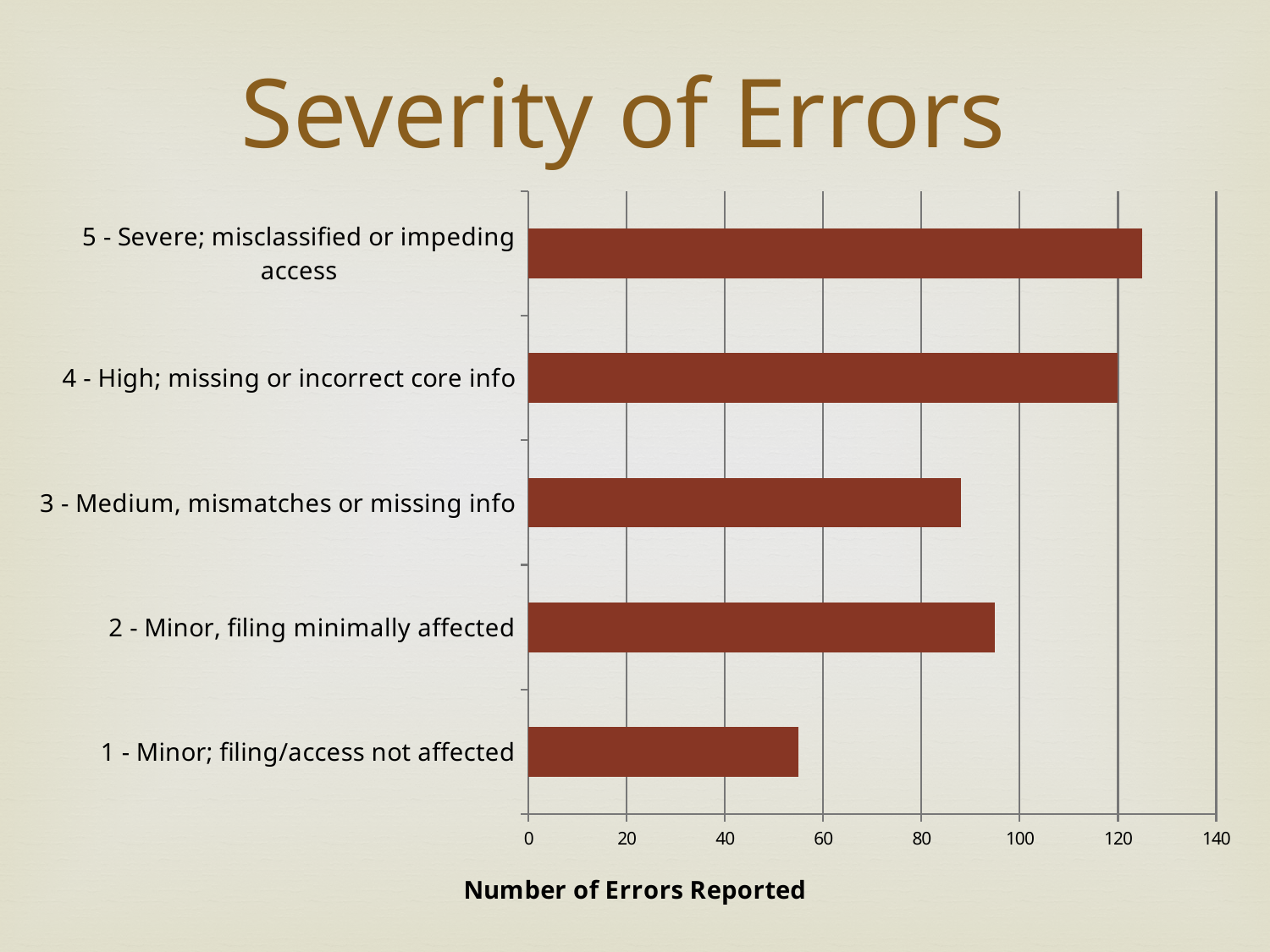
Is the value for "2 - Minor, filing minimally affected" greater or less than 100? less Which severity category has the highest number of errors reported? 5 - Severe; misclassified or impeding access How many severity categories are plotted in the chart? 5 Is the value for "3 - Medium, mismatches or missing info" greater or less than 80? greater What kind of chart is shown on the slide? bar chart Which has more errors reported: "2 - Minor, filing minimally affected" or "3 - Medium, mismatches or missing info"? 2 - Minor, filing minimally affected Which has more errors reported: "4 - High; missing or incorrect core info" or "1 - Minor; filing/access not affected"? 4 - High; missing or incorrect core info Which severity category has the lowest number of errors reported? 1 - Minor; filing/access not affected What is the title of the chart? Severity of Errors What is the label on the horizontal axis of the chart? Number of Errors Reported Is the value for "1 - Minor; filing/access not affected" greater or less than 60? less